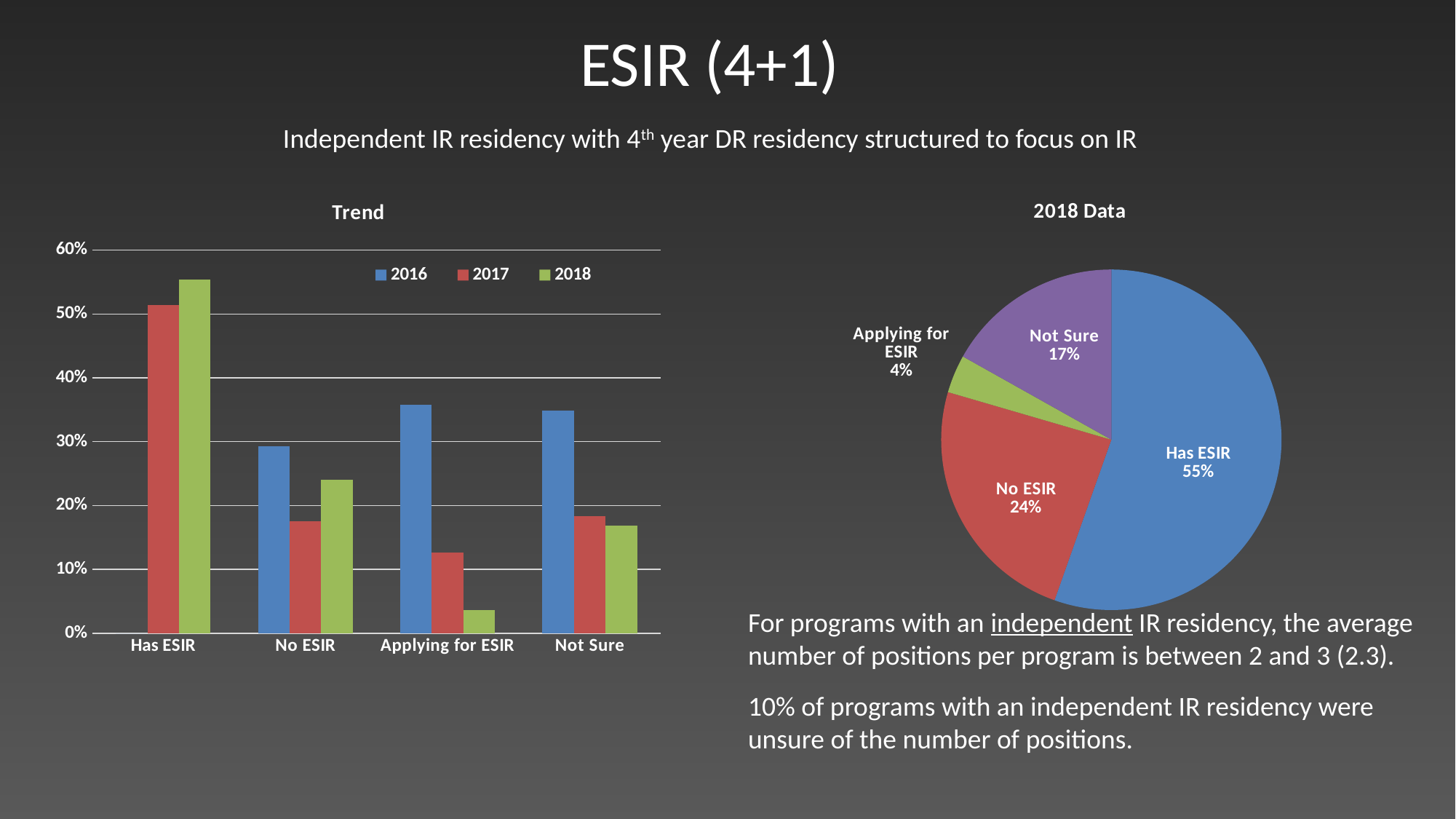
In the Trend chart, is the 2018 value for Applying for ESIR greater or less than 10%? less In the 2018 Data pie chart, how many slices are there? 4 In the Trend chart, is the 2018 value for Has ESIR greater or less than 50%? greater In the 2018 Data pie chart, what share does Applying for ESIR have? 4% In the 2018 Data pie chart, what share does Has ESIR have? 55% In the 2018 Data pie chart, which category has the smallest slice? Applying for ESIR In the 2018 Data pie chart, what share does No ESIR have? 24% How many series does the legend of the Trend chart list? 3 In the 2018 Data pie chart, what is the difference between the Has ESIR share and the No ESIR share? 31% What kind of chart is the Trend chart on the left? Bar chart In the 2018 Data pie chart, which category has the largest slice? Has ESIR In the Trend chart, which is larger for Applying for ESIR: the 2016 value or the 2017 value? 2016